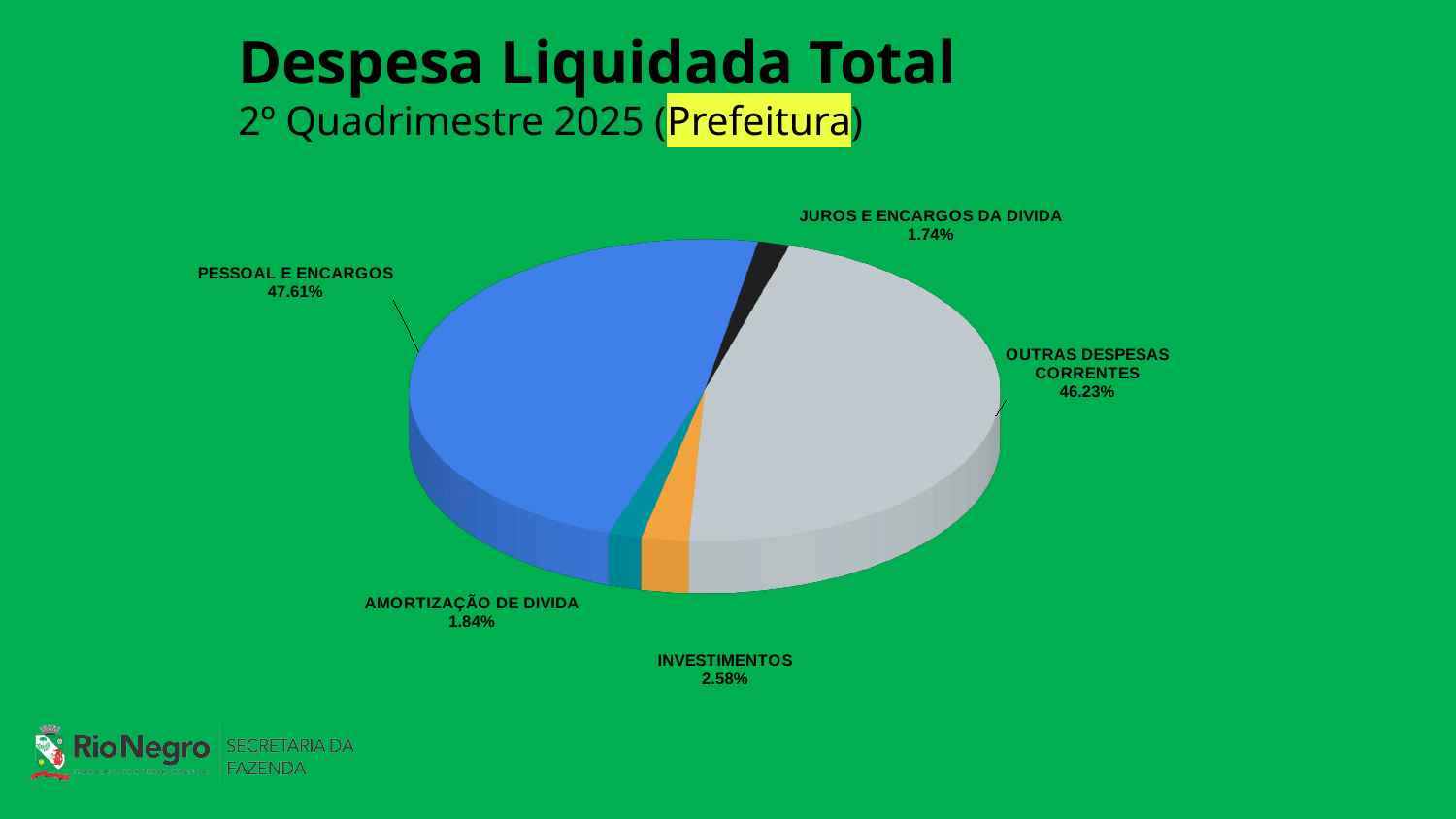
What is the value shown for OUTRAS DESPESAS CORRENTES? 46.23% What share of the pie does PESSOAL E ENCARGOS represent? 47.61% Which is larger, INVESTIMENTOS or AMORTIZAÇÃO DE DIVIDA? INVESTIMENTOS What is the value shown for INVESTIMENTOS? 2.58% What is the difference in percentage points between PESSOAL E ENCARGOS and OUTRAS DESPESAS CORRENTES? 1.38 What is the title of the chart on the slide? Despesa Liquidada Total Which category has the largest share of the pie? PESSOAL E ENCARGOS What is the value shown for AMORTIZAÇÃO DE DIVIDA? 1.84% How many categories are shown in the pie chart? 5 Which category has the smallest share of the pie? JUROS E ENCARGOS DA DIVIDA What kind of chart is shown on the slide? Pie chart What is the value shown for JUROS E ENCARGOS DA DIVIDA? 1.74%